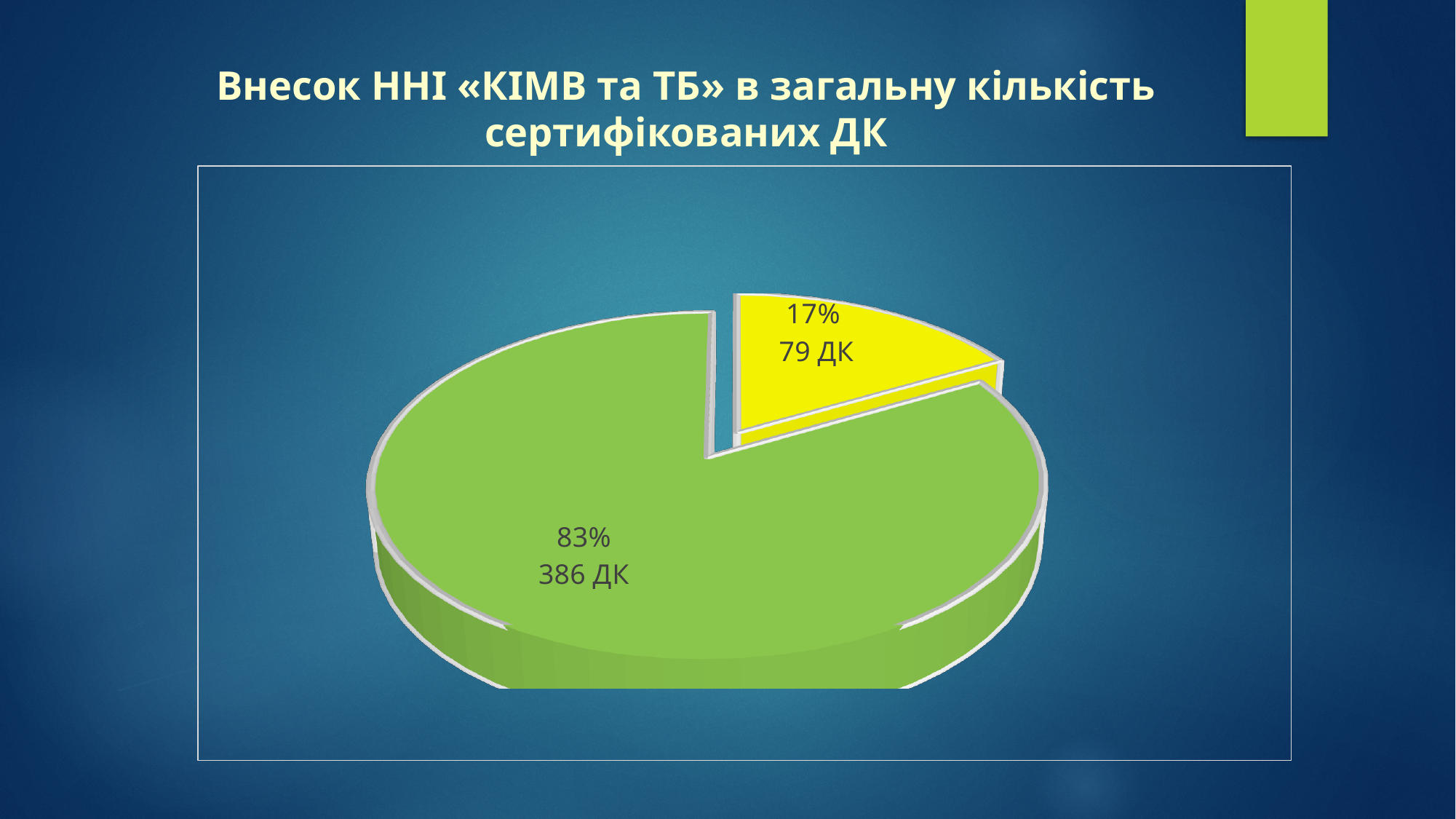
How many slices does the pie chart have? 2 What is the total number of ДК represented by both slices of the pie chart? 465 ДК What is the title of the slide containing the pie chart? Внесок ННІ «КІМВ та ТБ» в загальну кількість сертифікованих ДК What kind of chart is shown on the slide? pie chart Which slice of the pie chart is the smallest? the yellow slice (17%, 79 ДК) What value is printed on the green slice of the pie chart? 386 ДК What percentage share does the yellow slice of the pie chart represent? 17% What value is printed on the yellow slice of the pie chart? 79 ДК Which slice of the pie chart is the largest? the green slice (83%, 386 ДК) What percentage share does the green slice of the pie chart represent? 83% What is the difference in ДК between the green slice and the yellow slice? 307 ДК Which slice is larger, the yellow one or the green one? the green one